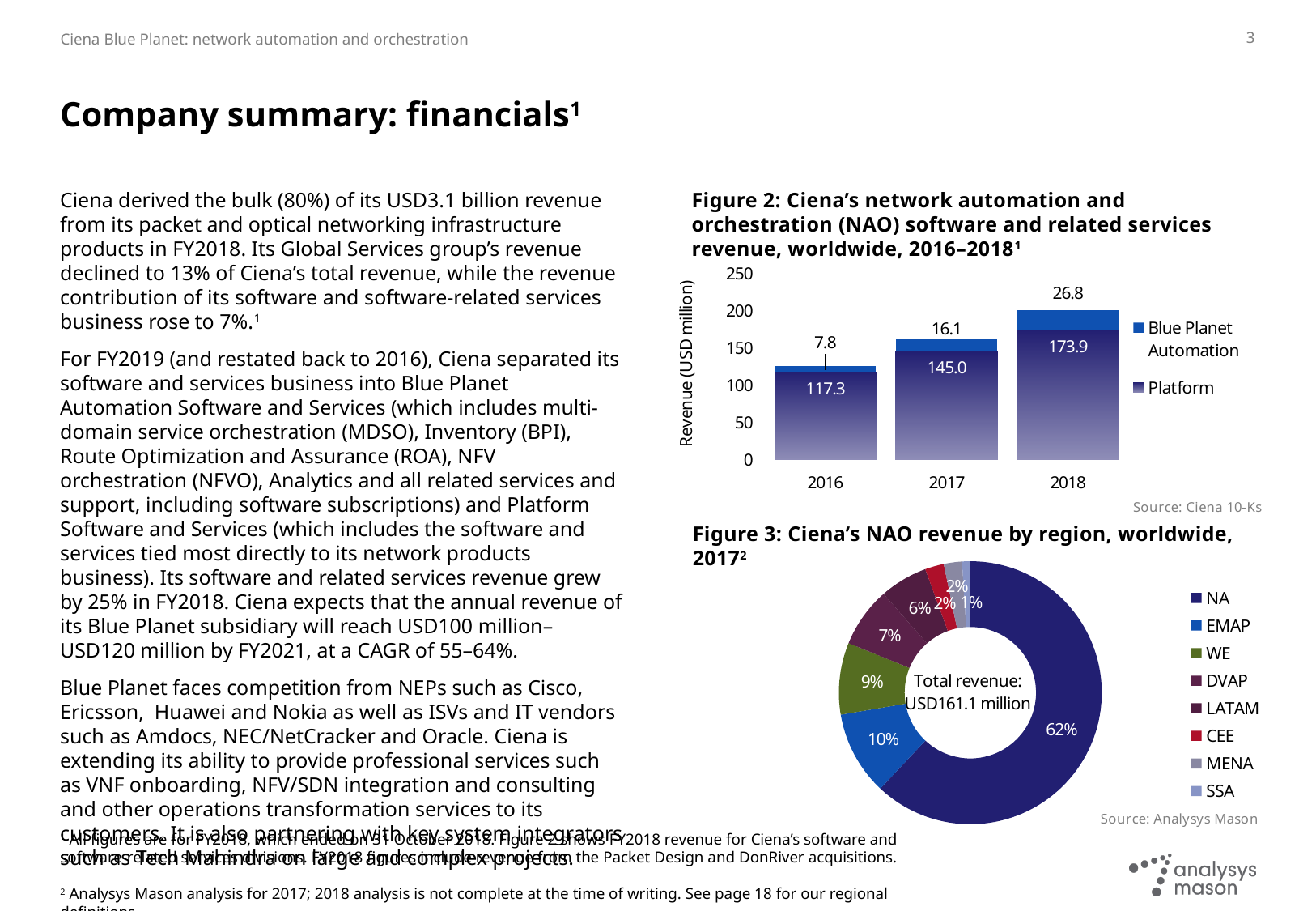
In Figure 3, what share of Ciena's NAO revenue came from NA in 2017? 62% In Figure 2, what was Ciena's Platform revenue in 2017? 145.0 What kind of chart is Figure 2? Stacked bar chart In Figure 2, what is the total NAO software and related services revenue for 2018 (Platform plus Blue Planet Automation)? 200.7 In Figure 3, what total revenue is shown in the centre of the donut chart? USD161.1 million In Figure 3, which region has the smallest share of NAO revenue? SSA In Figure 2, does the Platform revenue rise or fall from 2016 to 2018? rise In Figure 2, what was the Blue Planet Automation revenue in 2018? 26.8 In Figure 2, which year had the lowest Blue Planet Automation revenue? 2016 In Figure 2, how many series does the legend list? 2 In Figure 2, by how much did Platform revenue increase from 2016 to 2017? 27.7 In Figure 2, which year had the highest Platform revenue? 2018